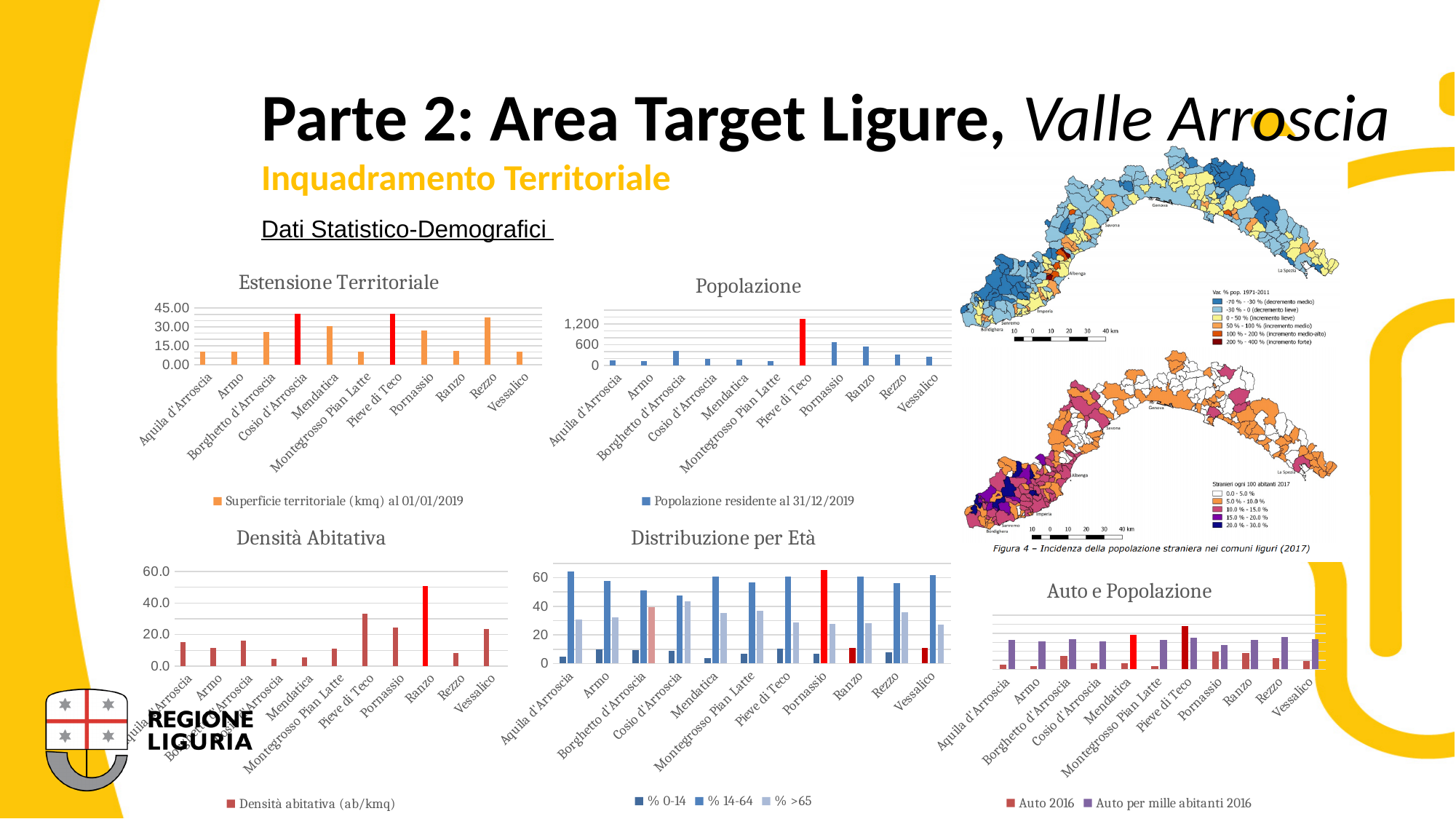
In the Popolazione chart, which municipality has the highest population? Pieve di Teco In the Densità Abitativa chart, which is larger, the value for Ranzo or the value for Pornassio? Ranzo In the Densità Abitativa chart, which municipality has the highest density? Ranzo In the Estensione Territoriale chart, how many municipalities are shown on the x axis? 11 How many series does the legend of the Distribuzione per Età chart list? 3 In the Popolazione chart, is the value for Pieve di Teco greater or less than 1,200? greater What kind of chart is the Auto e Popolazione chart? bar chart In the Estensione Territoriale chart, is the value for Armo greater or less than 15.00? less In the Distribuzione per Età chart, is the % 14-64 value for Cosio d'Arroscia greater or less than 40? greater